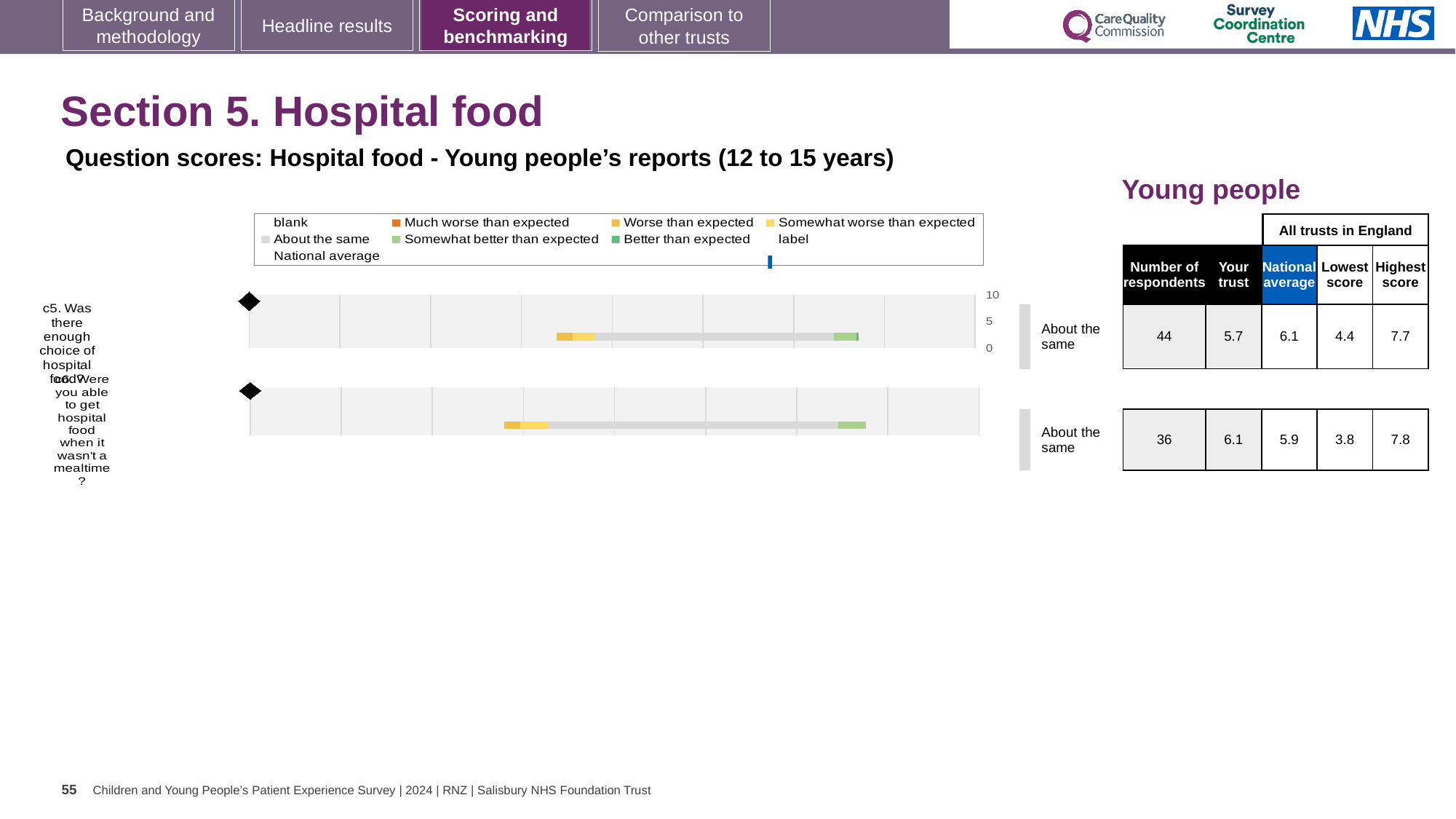
Which question has the larger 'Your trust' score in the table, c5 or c6? c6 What benchmark category is shown for both c5 and c6 next to the chart? About the same What kind of chart is used to show the question scores for c5 and c6? bar chart In the table next to the chart, what is the 'Your trust' score for c5 (enough choice of hospital food)? 5.7 What is the highest value shown on the chart's axis? 10 What is the title of the chart section shown above the table? Young people How many questions (categories) are plotted in the chart? 2 In the table next to the chart, what is the 'Your trust' score for c6 (able to get hospital food when it wasn't a mealtime)? 6.1 What is the difference between the Highest score and Lowest score for c5 in the table? 3.3 In the table next to the chart, what is the National average for c5? 6.1 In the table next to the chart, how many respondents answered c5? 44 In the table next to the chart, what is the Highest score for c6? 7.8